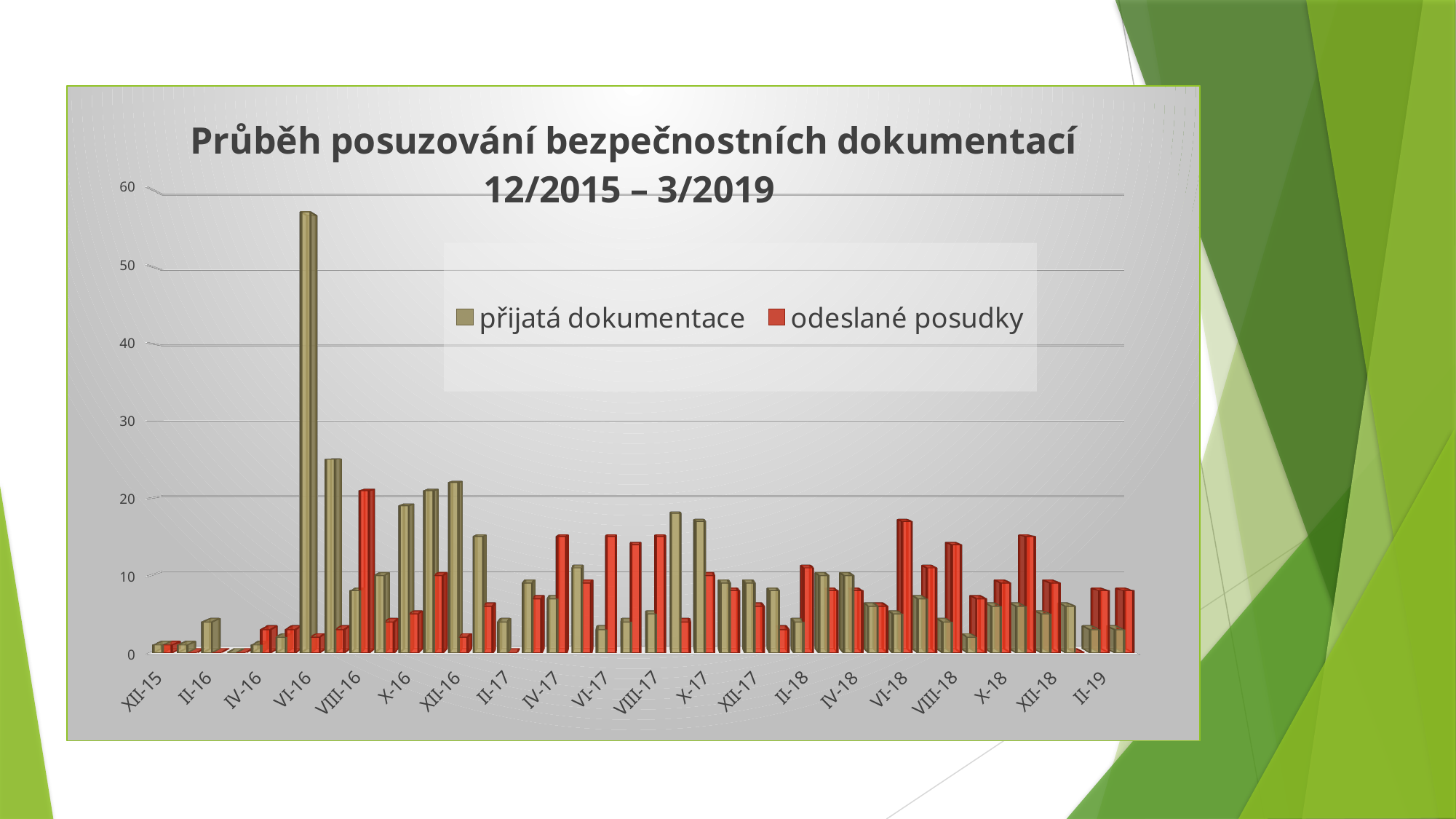
What kind of chart is shown on the slide? bar chart Is the value for odeslané posudky at VIII-16 greater or less than 10? greater What are the two series named in the legend? přijatá dokumentace, odeslané posudky How many series does the legend list? 2 Is the value for přijatá dokumentace at VI-16 greater or less than 50? greater At VI-16, which series has the larger value, přijatá dokumentace or odeslané posudky? přijatá dokumentace Which labeled month has the highest value for přijatá dokumentace? VI-16 Is the value for přijatá dokumentace at XII-16 greater or less than 10? greater Which labeled month has the highest value for odeslané posudky? VIII-16 At VI-18, which series has the larger value, přijatá dokumentace or odeslané posudky? odeslané posudky What is the title of the chart? Průběh posuzování bezpečnostních dokumentací 12/2015 – 3/2019